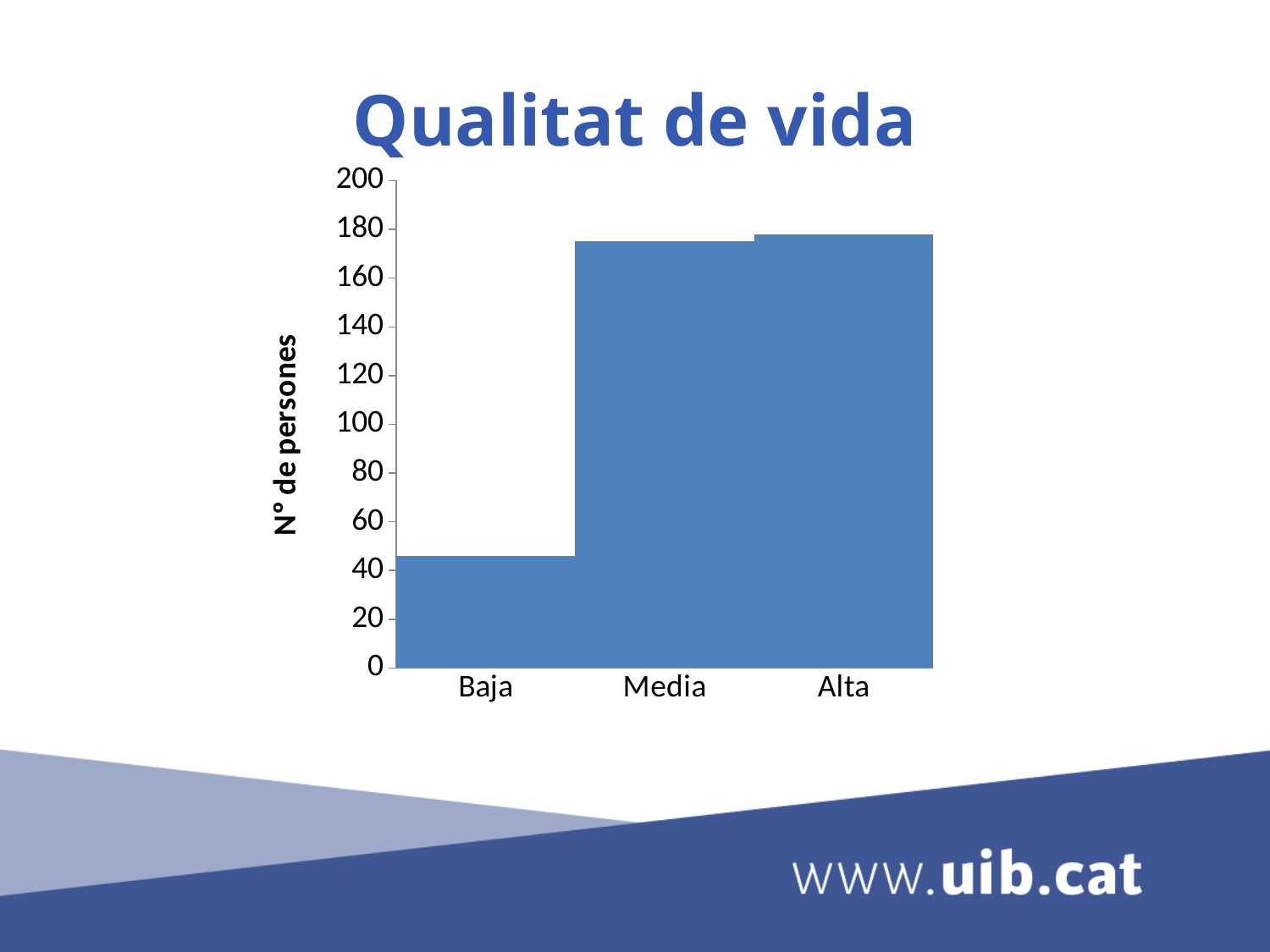
Is the value for Alta greater or less than 160? greater Is the value for Media greater or less than 160? greater Is the value for Baja greater or less than 100? less How many categories are shown on the x axis of the chart? 3 What kind of chart is shown on the slide? bar chart What is the label on the vertical axis of the chart? Nº de persones Which category has the lowest value in the chart? Baja Which is larger, the value for Baja or the value for Media? Media What is the title of the chart? Qualitat de vida Which is larger, the value for Baja or the value for Alta? Alta Do the values generally rise or fall from Baja to Alta along the x axis? rise